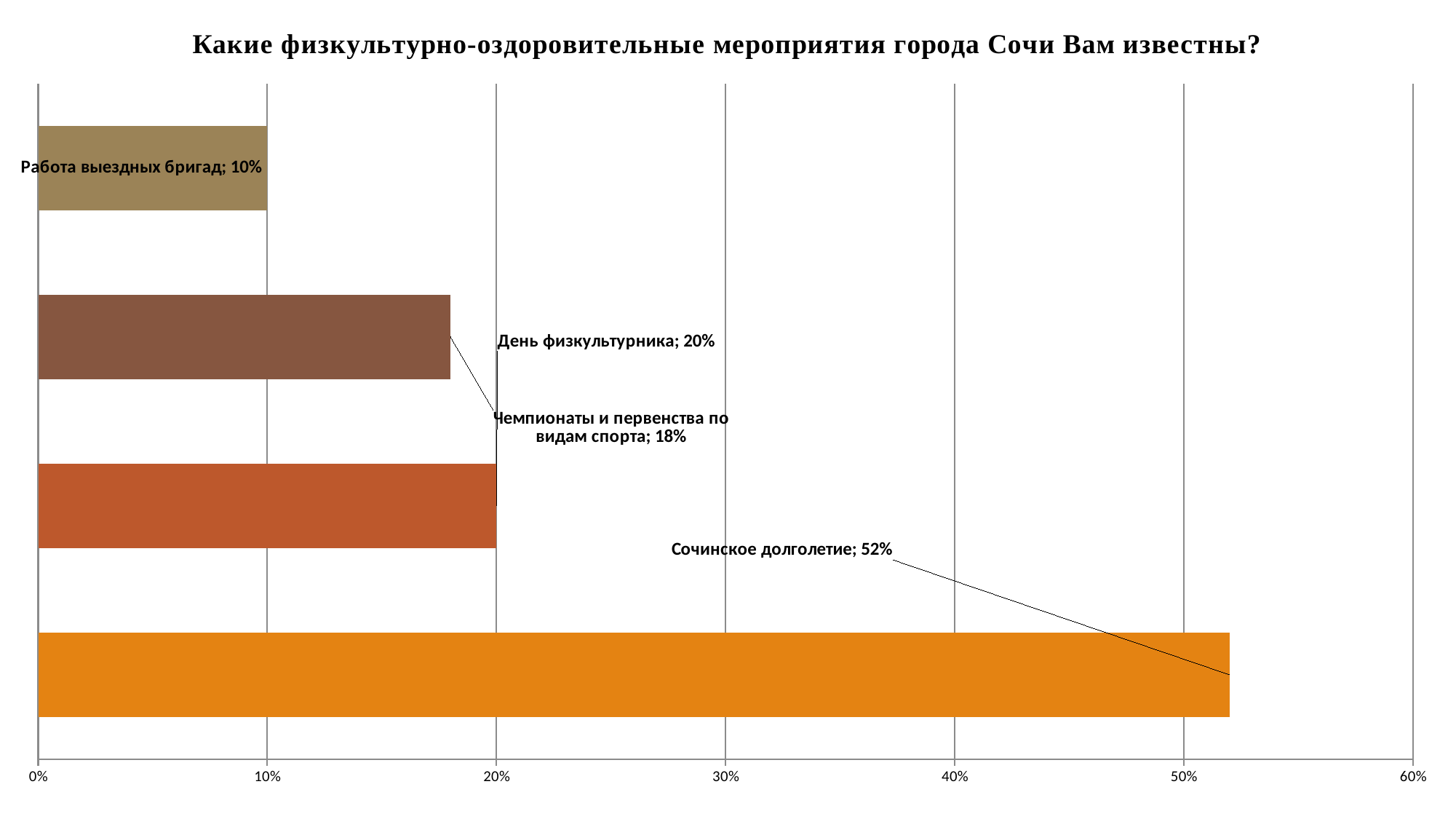
Which category has the lowest value? Работа выездных бригад What value is shown for «Работа выездных бригад»? 10% What value is shown for «Сочинское долголетие»? 52% Is the value for «Сочинское долголетие» greater or less than 50%? greater Which category has the highest value? Сочинское долголетие What value is shown for «Чемпионаты и первенства по видам спорта»? 18% What kind of chart is shown on the slide? Bar chart Which is larger: the value for «Чемпионаты и первенства по видам спорта» or the value for «Работа выездных бригад»? Чемпионаты и первенства по видам спорта How many categories are shown in the chart? 4 What value is shown for «День физкультурника»? 20% What is the difference between the values for «Сочинское долголетие» and «День физкультурника»? 32% What is the difference between the values for «День физкультурника» and «Чемпионаты и первенства по видам спорта»? 2%